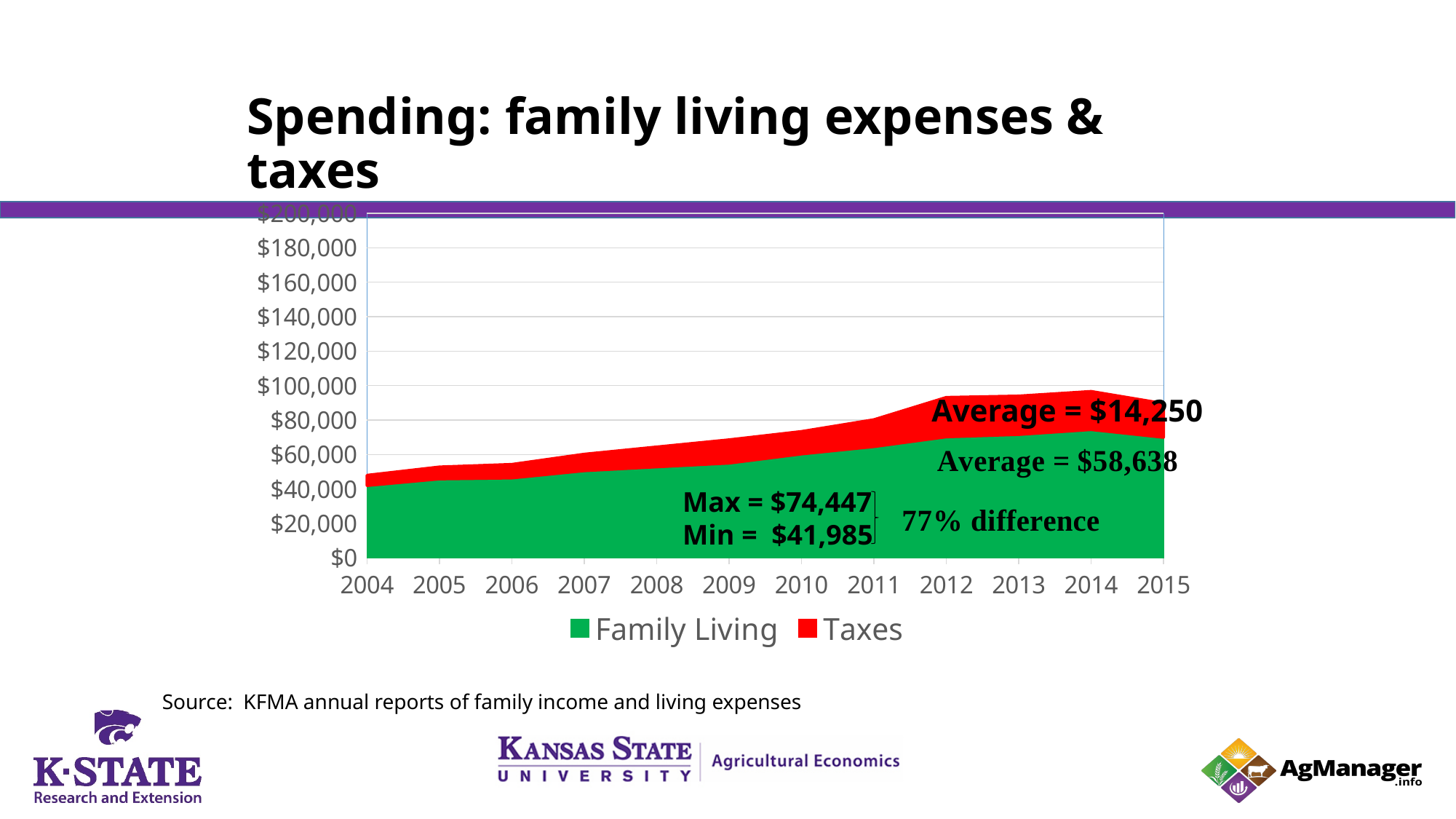
How many series does the legend list? 2 What is the maximum Family Living value stated on the chart? $74,447 What kind of chart is shown on the slide? Area chart What is the average value for Family Living stated on the chart? $58,638 What is the difference between the stated Max and Min Family Living values? $32,462 Does Family Living spending generally rise or fall from 2004 to 2014? rise Is the Family Living value for 2004 greater or less than $60,000? less Which series is shown in green? Family Living Is the Family Living value for 2014 greater or less than $60,000? greater What is the minimum Family Living value stated on the chart? $41,985 What is the average value for Taxes stated on the chart? $14,250 How many years are shown on the x axis? 12